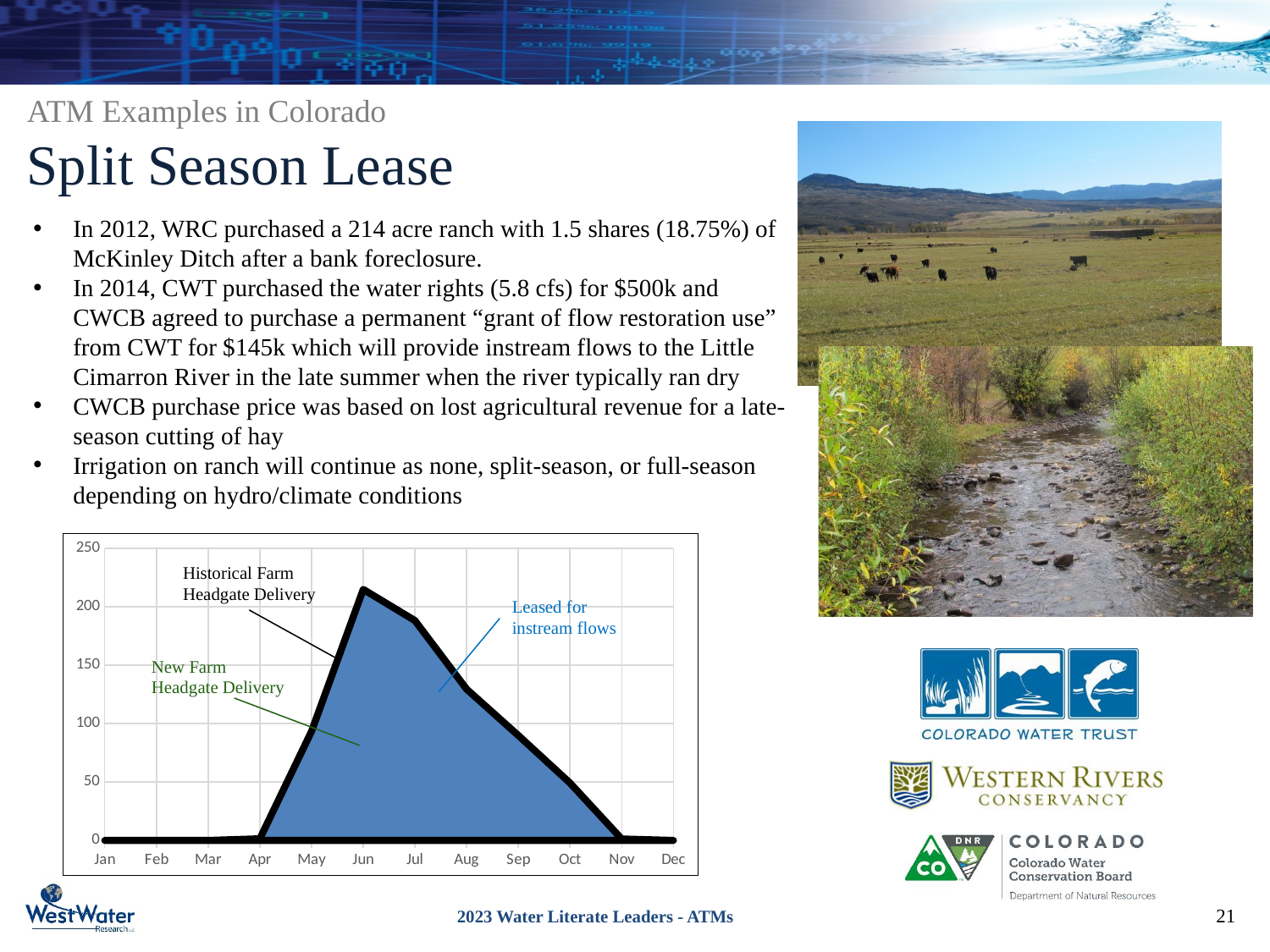
Which month has the larger Historical Farm Headgate Delivery value, Jun or Sep? Jun Is the Historical Farm Headgate Delivery value for Jun greater or less than 200? greater Is the Historical Farm Headgate Delivery value for May greater or less than 50? greater Do the Historical Farm Headgate Delivery values rise or fall from Jun to Nov? fall What is the Historical Farm Headgate Delivery value for Jan? 0 What kind of chart is shown on the slide? area chart How many months are shown along the x axis of the chart? 12 What does the blue annotation on the chart say the Jul–Aug portion of the delivery is used for? Leased for instream flows Is the Historical Farm Headgate Delivery value for Aug greater or less than 150? less In which month does the Historical Farm Headgate Delivery reach its highest value? Jun What is the Historical Farm Headgate Delivery value for Dec? 0